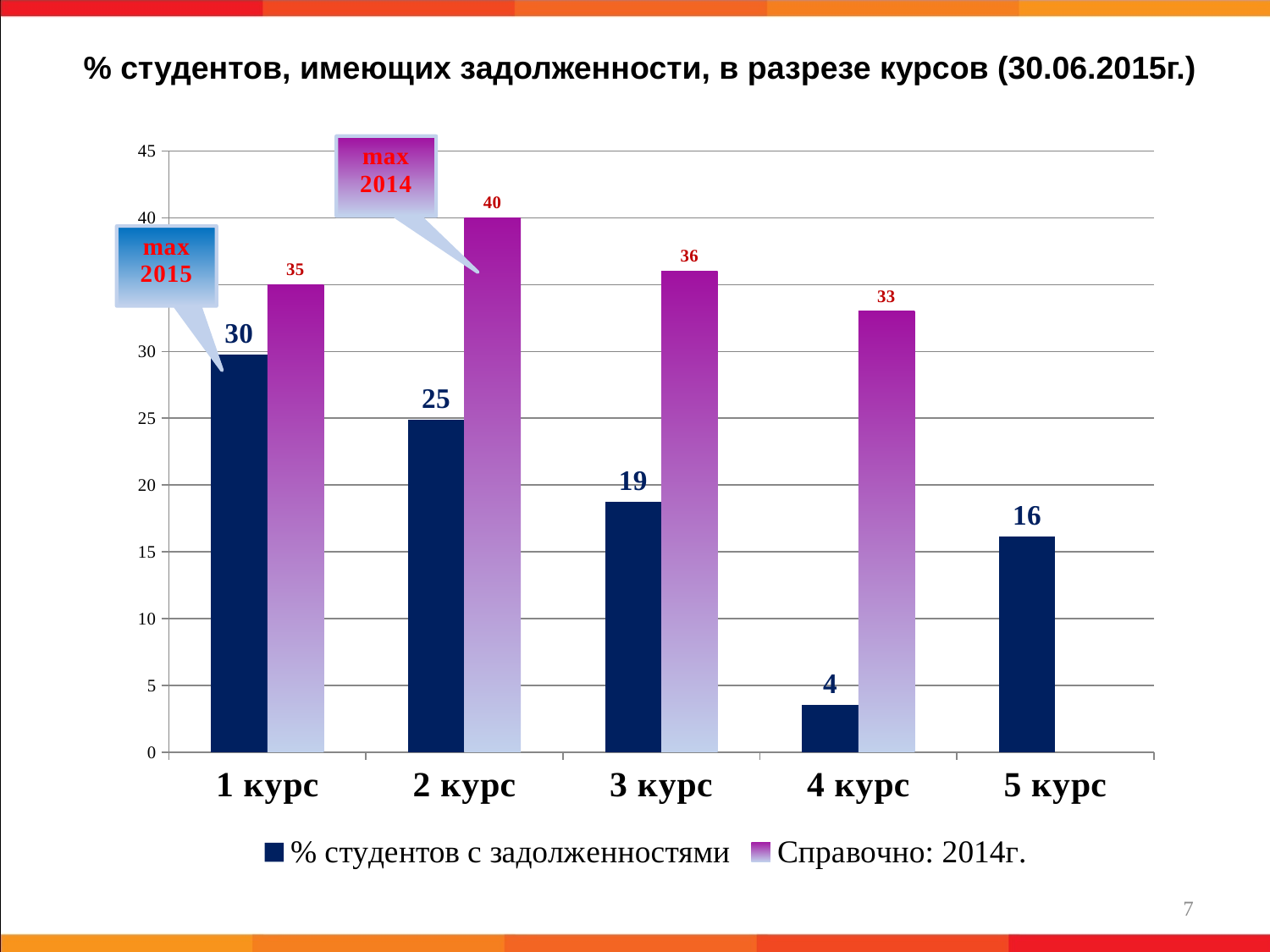
How many series does the legend list? 2 Which is larger for 2 курс: the '% студентов с задолженностями' value or the 'Справочно: 2014г.' value? Справочно: 2014г. Which course has the highest value in the series '% студентов с задолженностями'? 1 курс What is the value for 4 курс in the series '% студентов с задолженностями'? 4 Which course is labelled with the 'max 2014' callout? 2 курс What kind of chart is shown on the slide? bar chart Which course has the lowest value in the series 'Справочно: 2014г.'? 4 курс What is the difference between the 'Справочно: 2014г.' value and the '% студентов с задолженностями' value for 3 курс? 17 What is the value for 1 курс in the series '% студентов с задолженностями'? 30 How many courses are shown on the x axis? 5 What is the value for 2 курс in the series 'Справочно: 2014г.'? 40 Is the value for 5 курс in the series '% студентов с задолженностями' greater or less than 20? less